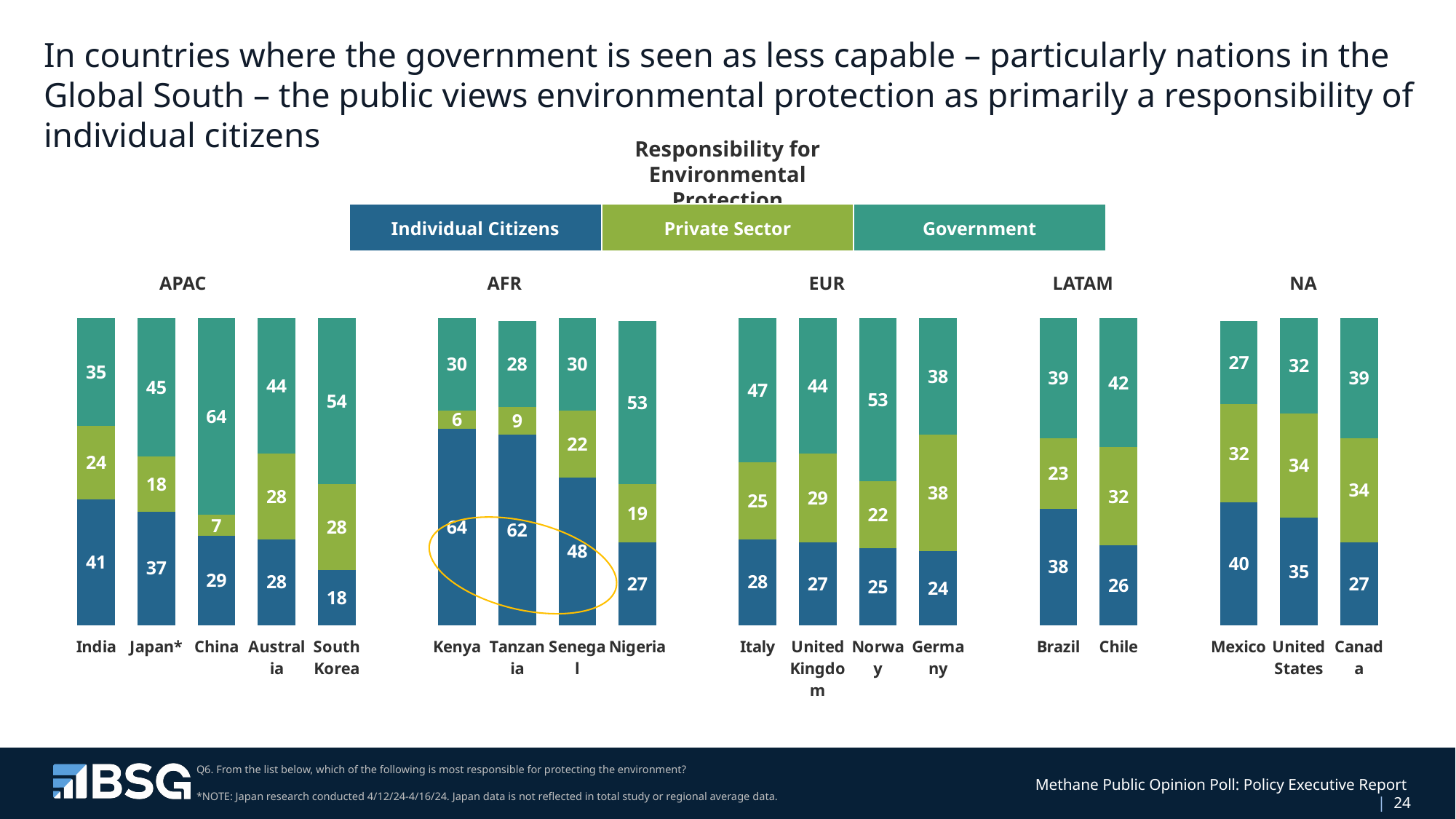
In the NA chart, what is the total of the stacked bar for Canada? 100 What kind of chart is used to show the data on this slide? Stacked bar chart How many countries are shown in the LATAM chart? 2 What is the title shown above the legend? Responsibility for Environmental Protection How many series does the legend list? 3 In the EUR chart, which has the larger Individual Citizens value, Italy or Germany? Italy In the APAC chart, which country has the highest Government value? China In the APAC chart, what is the Individual Citizens value for India? 41 In the EUR chart, what is the Private Sector value for Germany? 38 In the AFR chart, which country has the lowest Private Sector value? Kenya In the AFR chart, what is the Government value for Nigeria? 53 In the AFR chart, what is the difference between the Individual Citizens values for Kenya and Tanzania? 2